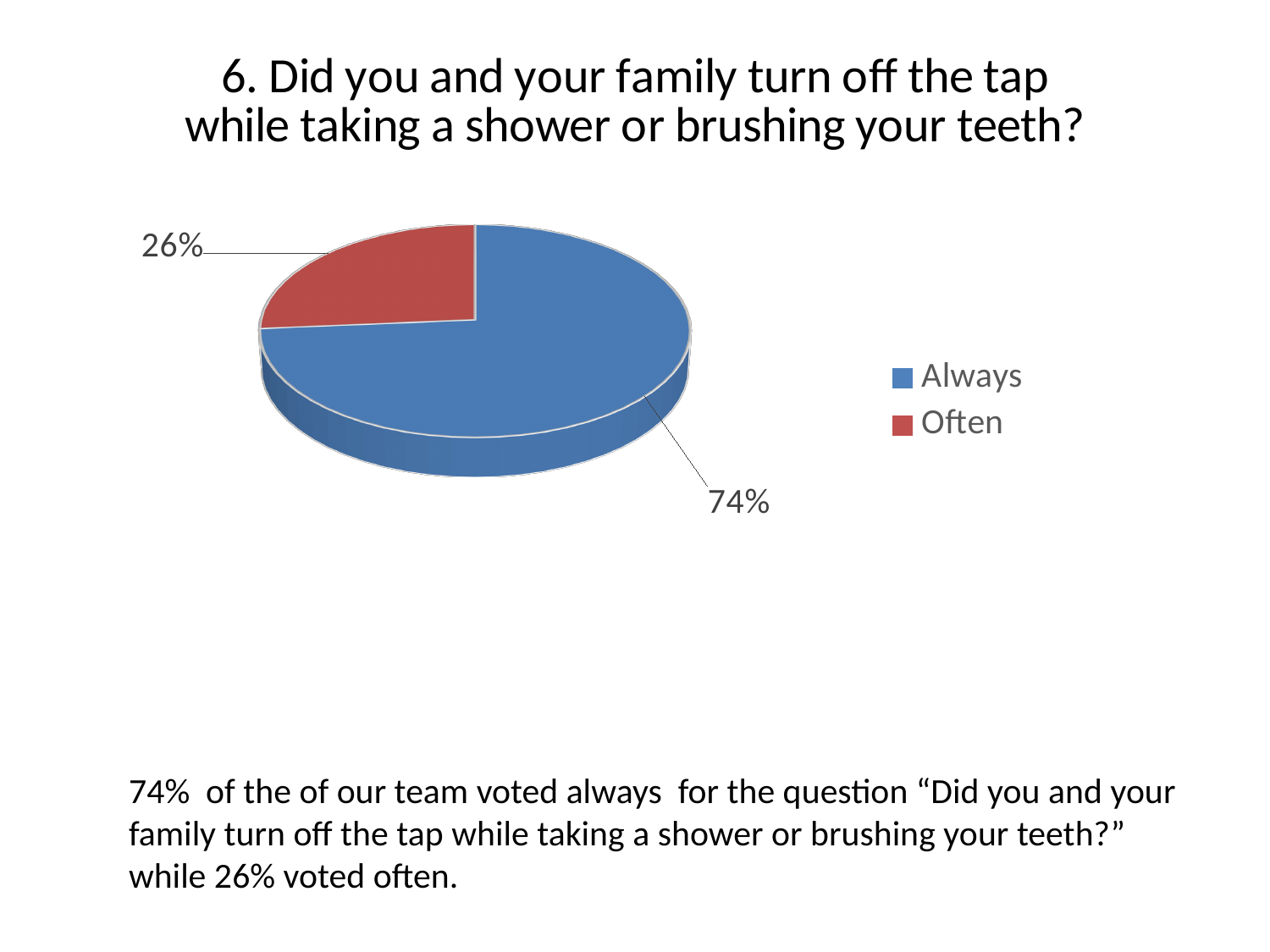
Which slice is larger, Always or Often? Always What colour is the Often slice in the pie chart? Red What share of the pie does the Always slice represent? 74% Which category has the largest slice of the pie? Always What kind of chart is shown on the slide? Pie chart Which category has the smallest slice of the pie? Often What is the difference in percentage points between the Always and Often slices? 48 How many categories does the pie chart show? 2 What are the two entries listed in the chart legend? Always and Often Is the share for Always greater or less than 50%? greater What share of the pie does the Often slice represent? 26%